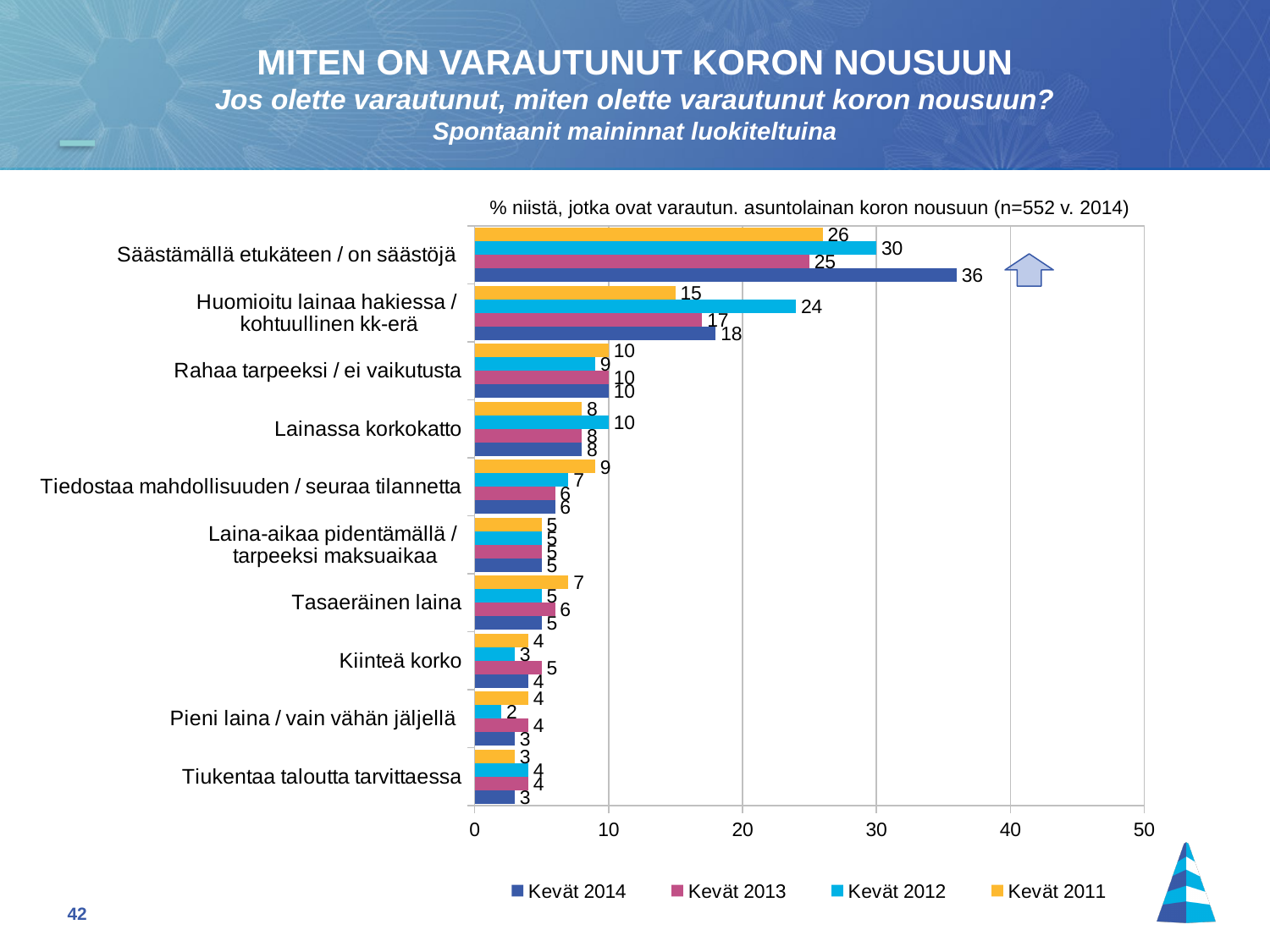
What is the Kevät 2014 value for 'Säästämällä etukäteen / on säästöjä'? 36 Is the Kevät 2012 value for 'Säästämällä etukäteen / on säästöjä' greater or less than 20? greater Which legend entry is shown in yellow? Kevät 2011 What is the Kevät 2012 value for 'Huomioitu lainaa hakiessa / kohtuullinen kk-erä'? 24 Which category has the highest Kevät 2014 value? Säästämällä etukäteen / on säästöjä What kind of chart is shown on the slide? bar chart What is the Kevät 2012 value for 'Pieni laina / vain vähän jäljellä'? 2 For 'Huomioitu lainaa hakiessa / kohtuullinen kk-erä', which is larger: the Kevät 2012 value or the Kevät 2014 value? Kevät 2012 What is the Kevät 2011 value for 'Tiedostaa mahdollisuuden / seuraa tilannetta'? 9 How many categories are shown on the chart? 10 What is the difference between the Kevät 2014 and Kevät 2013 values for 'Säästämällä etukäteen / on säästöjä'? 11 How many series does the legend list? 4